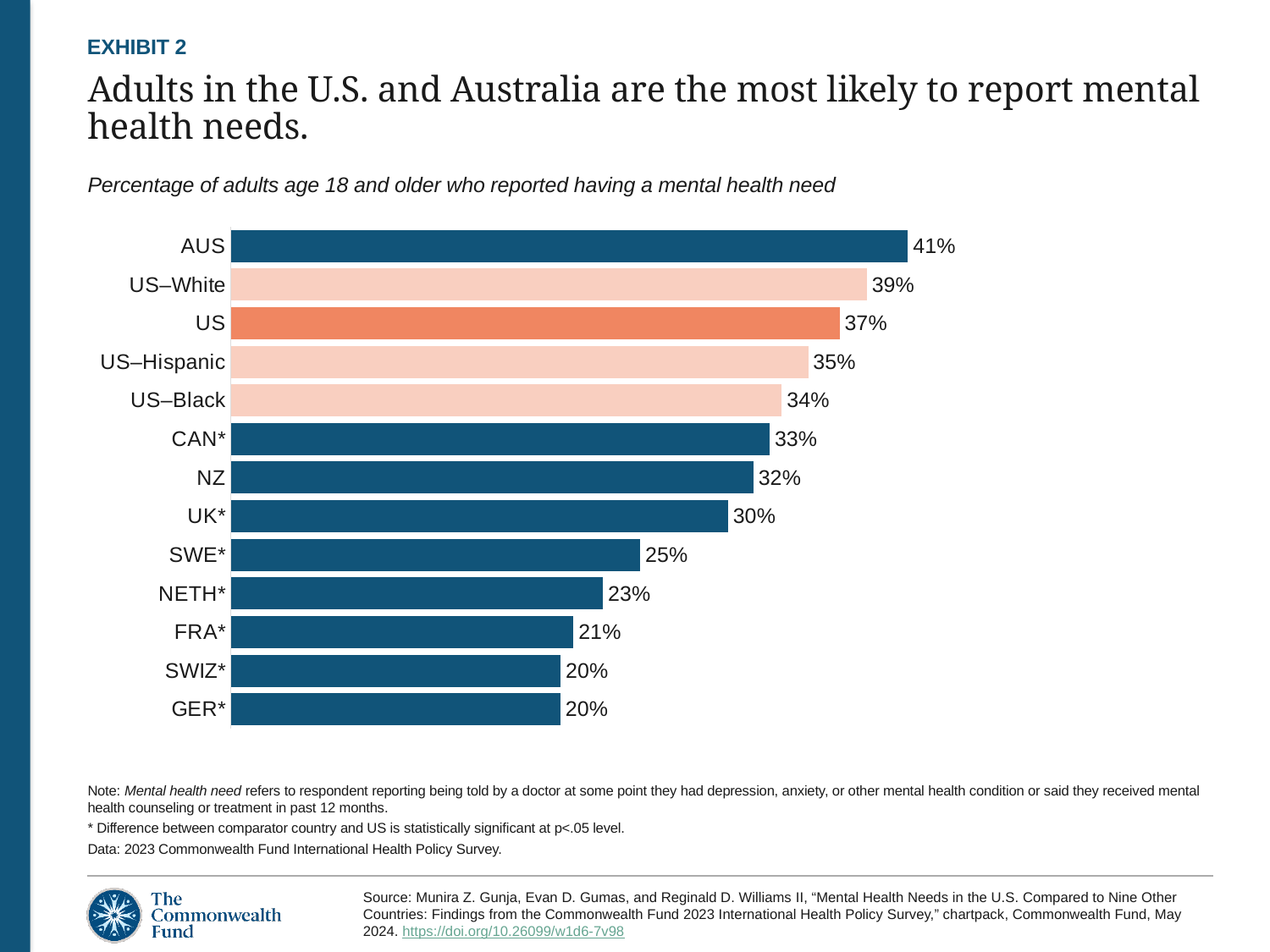
What percentage of adults in AUS reported having a mental health need? 41% Which is larger, the value for US or the value for NZ? US Which bar is shown in a darker orange colour than the other US bars? US What is the lowest value shown on the chart? 20% How many categories (bars) are shown on the chart? 13 What is the difference between the values for US–White and US–Black? 5 percentage points What percentage is shown for NETH*? 23% What is the difference between the values for AUS and GER*? 21 percentage points What kind of chart is shown on the slide? Bar chart Which category has the highest percentage of adults reporting a mental health need? AUS Which is larger, the value for CAN* or the value for UK*? CAN* What is the value shown for US–Hispanic? 35%